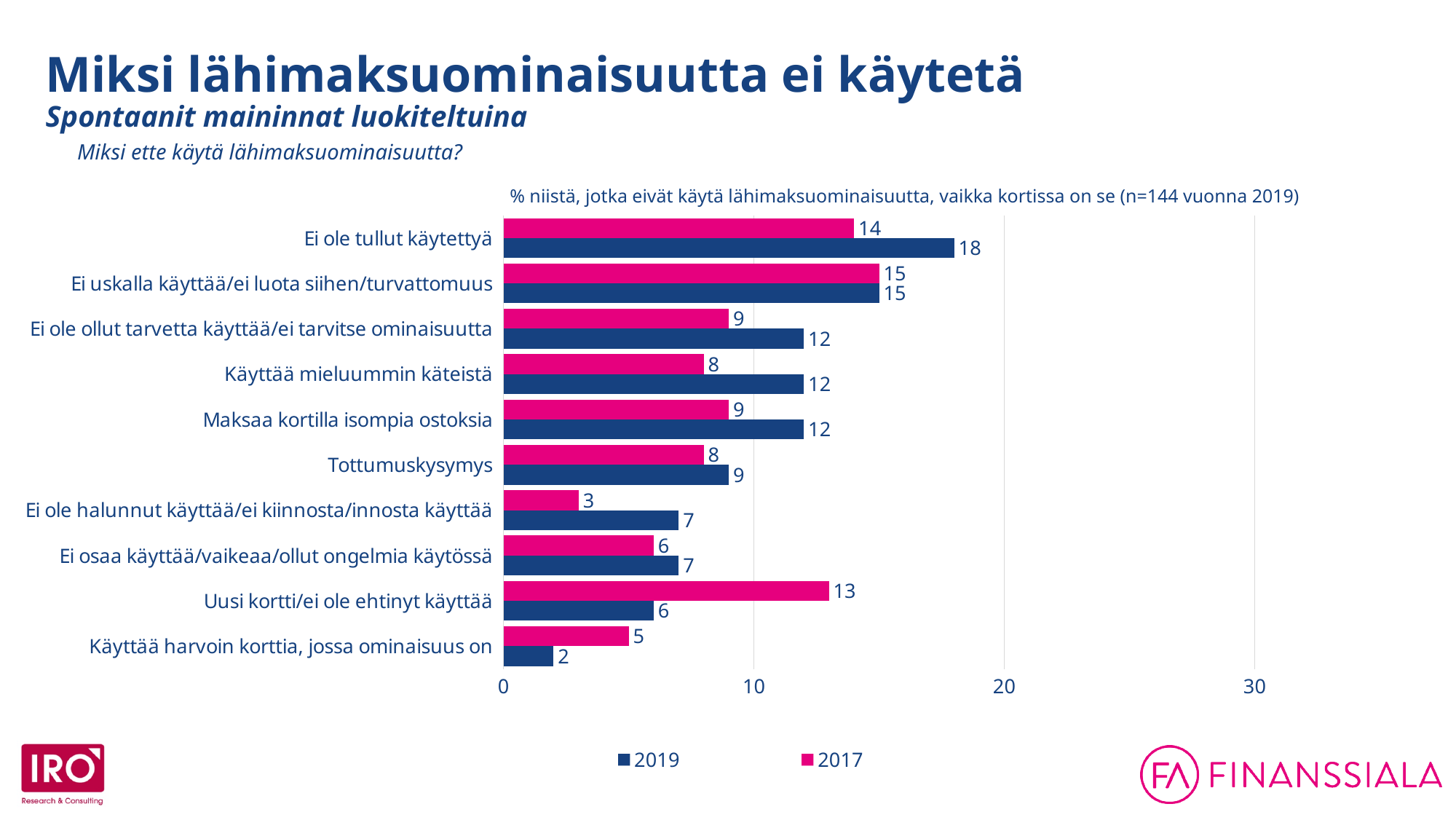
How many categories are shown on the chart? 10 What kind of chart is shown on the slide? Bar chart Which category has the lowest 2019 value? Käyttää harvoin korttia, jossa ominaisuus on Which category has the lowest 2017 value? Ei ole halunnut käyttää/ei kiinnosta/innosta käyttää What is the 2019 value for "Ei ole tullut käytettyä"? 18 How many series does the legend list? 2 What is the difference between the 2019 and 2017 values for "Ei ole tullut käytettyä"? 4 For "Ei ole halunnut käyttää/ei kiinnosta/innosta käyttää", which year has the larger value, 2019 or 2017? 2019 What is the 2017 value for "Uusi kortti/ei ole ehtinyt käyttää"? 13 What is the 2019 value for "Käyttää mieluummin käteistä"? 12 Which category has the highest 2019 value? Ei ole tullut käytettyä What is the difference between the 2017 and 2019 values for "Uusi kortti/ei ole ehtinyt käyttää"? 7